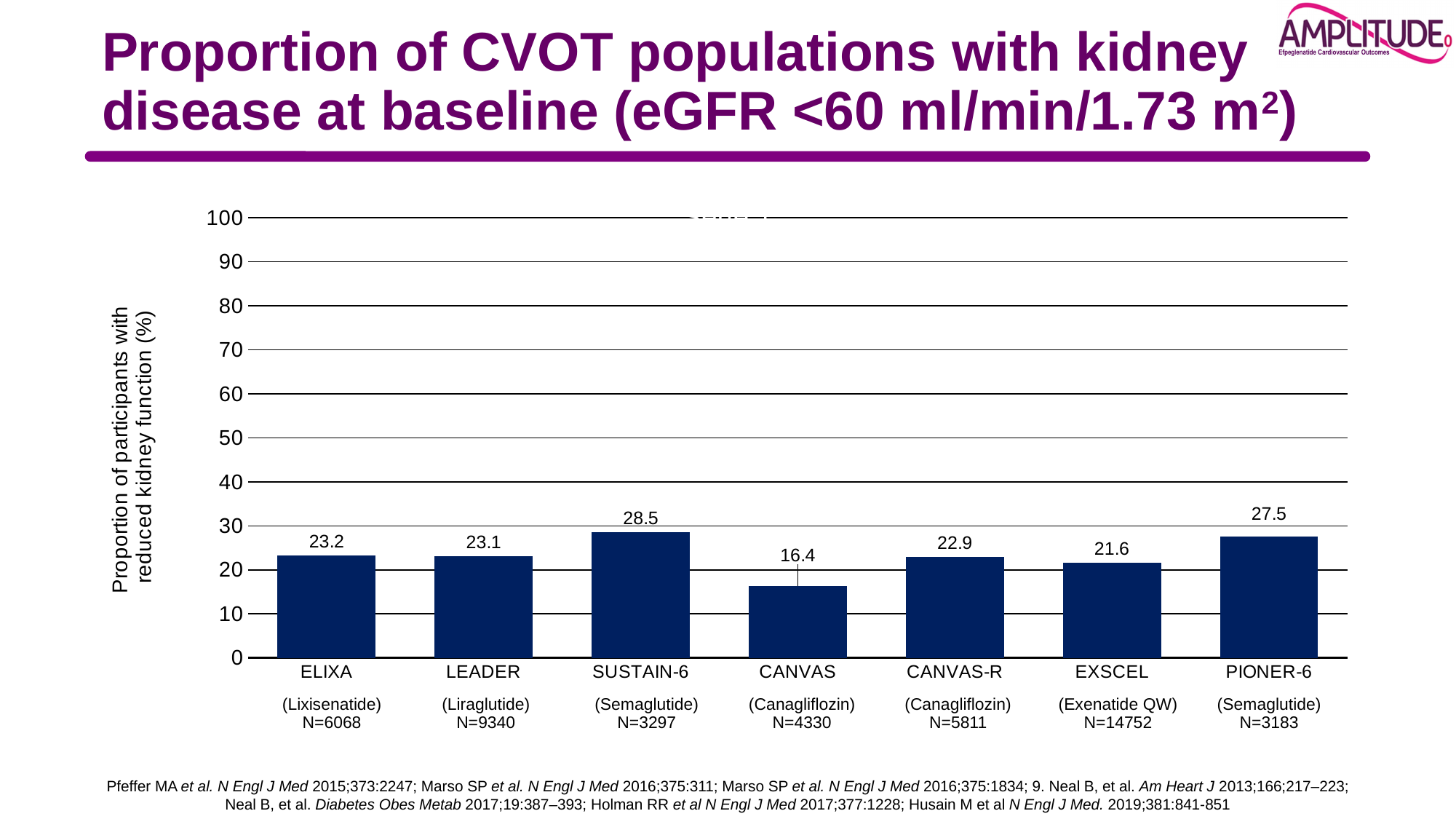
What is the value for SUSTAIN-6? 28.5 Which is larger, the value for ELIXA or the value for CANVAS-R? ELIXA What is the difference between the values for SUSTAIN-6 and CANVAS? 12.1 How many trials are shown on the x axis? 7 What is the label of the y axis? Proportion of participants with reduced kidney function (%) Which trial has the lowest proportion of participants with reduced kidney function? CANVAS What kind of chart is shown on the slide? Bar chart What is the value for CANVAS? 16.4 What is the value for PIONER-6? 27.5 Which trial has the highest proportion of participants with reduced kidney function? SUSTAIN-6 What is the value for EXSCEL? 21.6 What is the difference between the values for PIONER-6 and EXSCEL? 5.9